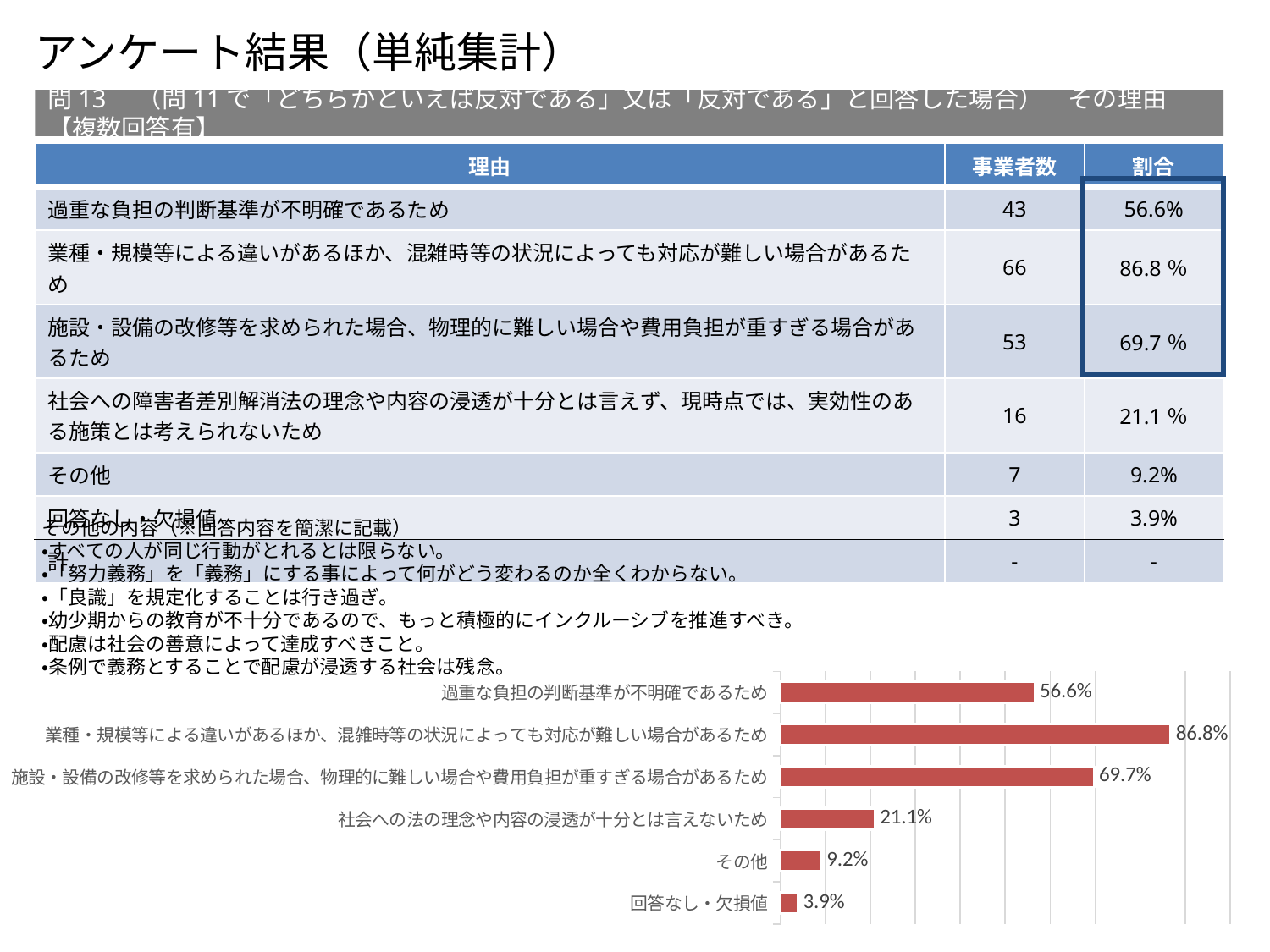
Which category has the lowest value in the chart? 回答なし・欠損値 What is the value shown for 社会への法の理念や内容の浸透が十分とは言えないため in the chart? 21.1% What is the difference between the values for 業種・規模等による違いがあるほか、混雑時等の状況によっても対応が難しい場合があるため and 施設・設備の改修等を求められた場合、物理的に難しい場合や費用負担が重すぎる場合があるため? 17.1% Which is larger in the chart: the value for その他 or the value for 回答なし・欠損値? その他 What is the difference between the values for 過重な負担の判断基準が不明確であるため and 社会への法の理念や内容の浸透が十分とは言えないため? 35.5% What is the value shown for 施設・設備の改修等を求められた場合、物理的に難しい場合や費用負担が重すぎる場合があるため in the chart? 69.7% What kind of chart is shown at the bottom of the slide? bar chart How many categories (bars) does the chart show? 6 What is the value shown for 業種・規模等による違いがあるほか、混雑時等の状況によっても対応が難しい場合があるため in the chart? 86.8% What is the value shown for 過重な負担の判断基準が不明確であるため in the chart? 56.6% Which category has the highest value in the chart? 業種・規模等による違いがあるほか、混雑時等の状況によっても対応が難しい場合があるため What is the value shown for 回答なし・欠損値 in the chart? 3.9%